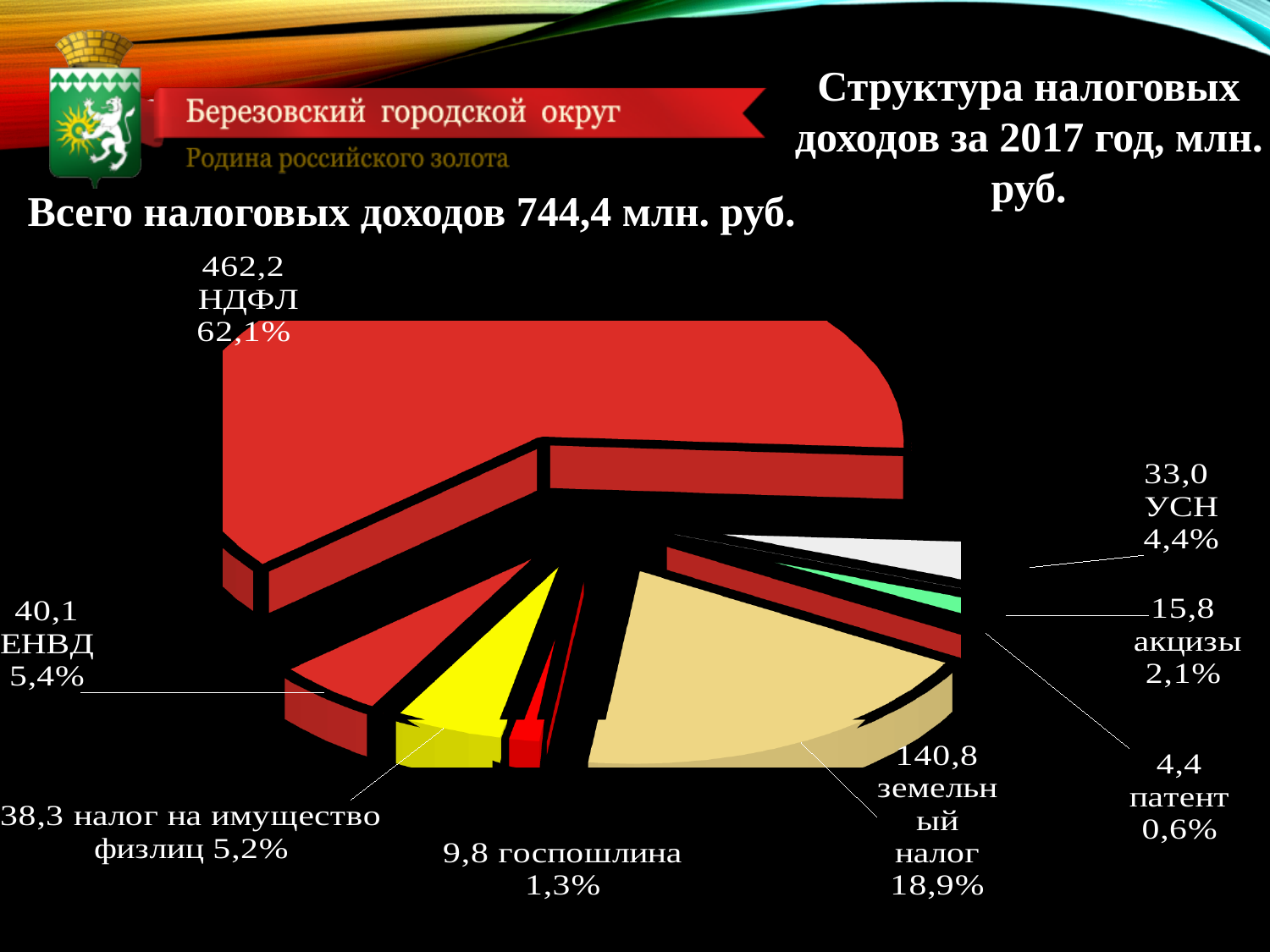
How many slices does the pie chart have? 8 Which category has the largest slice in the pie chart? НДФЛ What kind of chart is shown on the slide? pie chart What is the title of the chart on the slide? Структура налоговых доходов за 2017 год, млн. руб. What is the difference between the values for ЕНВД and налог на имущество физлиц? 1,8 What is the value for НДФЛ in the pie chart? 462,2 Which category has the smallest slice in the pie chart? патент What is the value for УСН in the pie chart? 33,0 What is the difference between the values for земельный налог and УСН? 107,8 What share of the pie does патент represent? 0,6% Which is larger, the value for акцизы or the value for госпошлина? акцизы What share of the pie does земельный налог represent? 18,9%